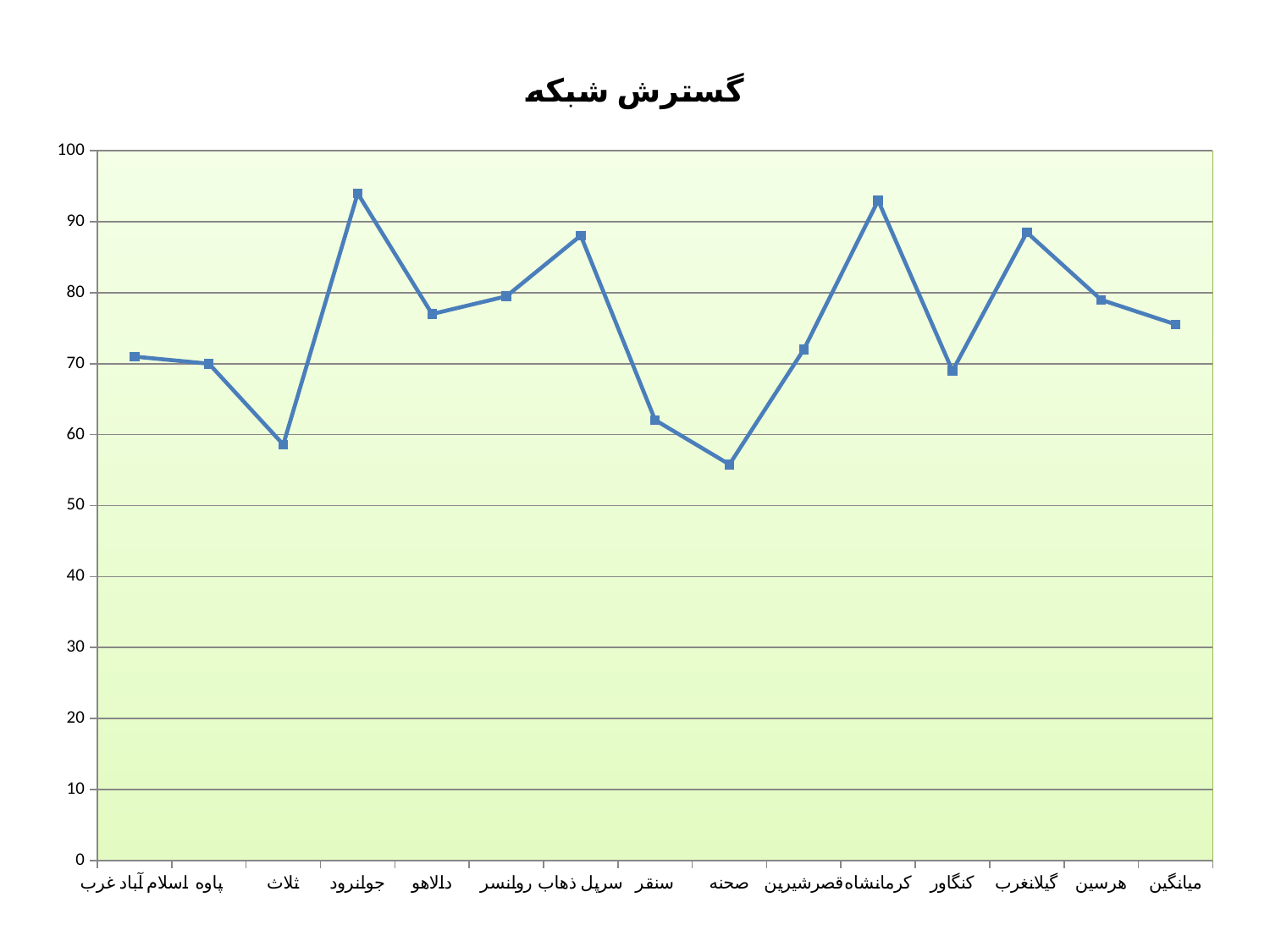
Which is larger, the value for سرپل ذهاب or the value for سنقر? سرپل ذهاب Do the values rise or fall from سرپل ذهاب to صحنه? fall How many categories are plotted along the x axis? 15 Is the value for میانگین greater or less than 70? greater Is the value for صحنه greater or less than 60? less What is the title of the chart? گسترش شبکه Which category has the lowest value? صحنه Which is larger, the value for کرمانشاه or the value for کنگاور? کرمانشاه Is the value for جوانرود greater or less than 90? greater What kind of chart is shown on the slide? line chart